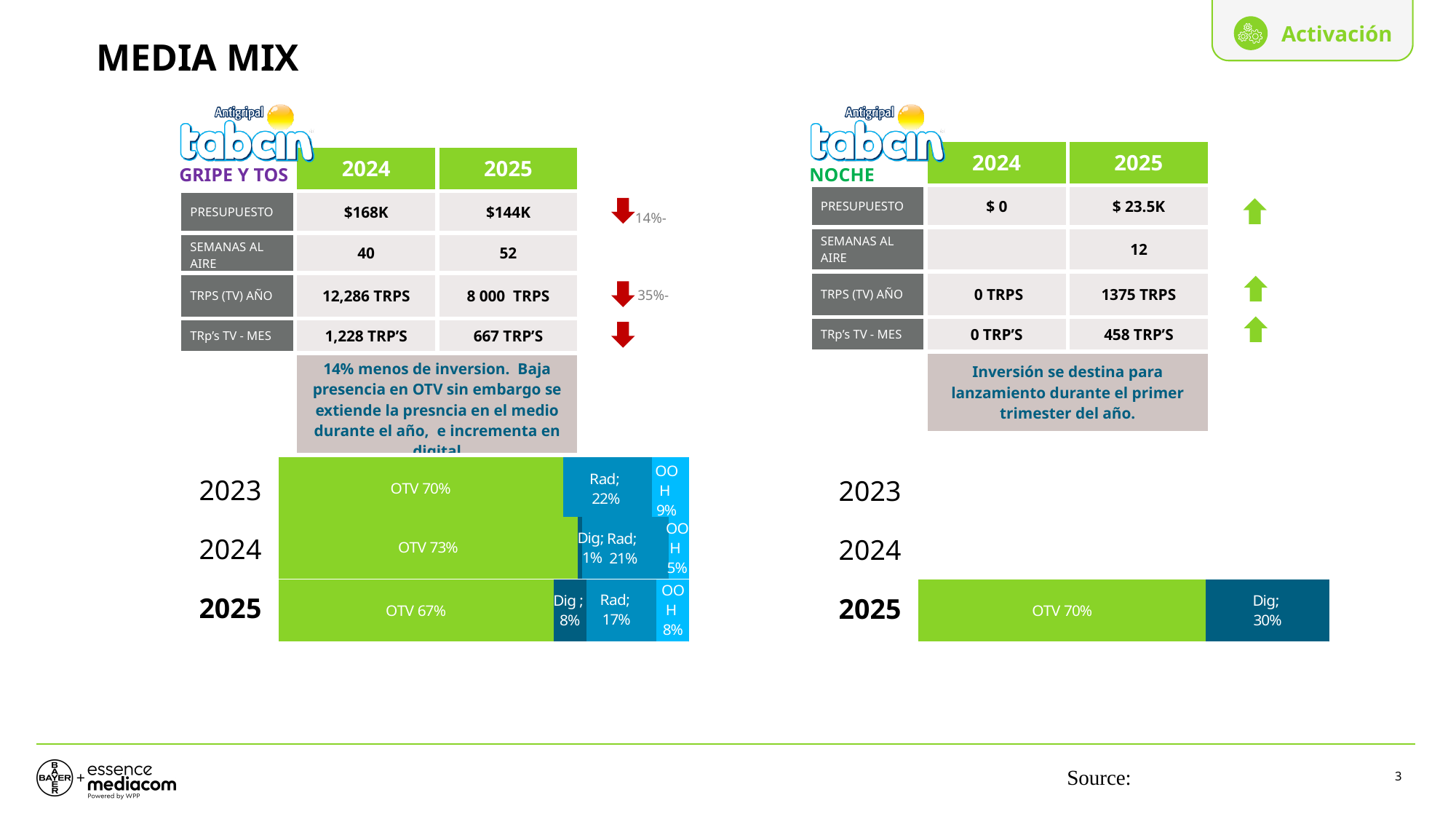
In the left chart (Gripe y Tos), is the Rad share larger in 2024 or in 2025? 2024 In the left chart (Gripe y Tos), which year has the highest OTV share? 2024 In the left chart (Gripe y Tos), what is the difference between the Rad share in 2023 and in 2025? 5 percentage points In the left chart (Gripe y Tos), which year has the lowest OTV share? 2025 In the left chart (Gripe y Tos), does the Rad share rise or fall from 2023 to 2025? Fall In the right chart (Noche), what is the OTV share for 2025? 70% In the left chart (Gripe y Tos), what is the Dig share for 2024? 1% In the left chart (Gripe y Tos), how many years are shown with bars? 3 What kind of chart is used at the bottom of the slide to show the media mix? Stacked bar chart In the left chart (Gripe y Tos), what is the Rad share for 2023? 22% In the right chart (Noche), what is the Dig share for 2025? 30% In the left chart (Gripe y Tos), what is the OTV share for 2025? 67%